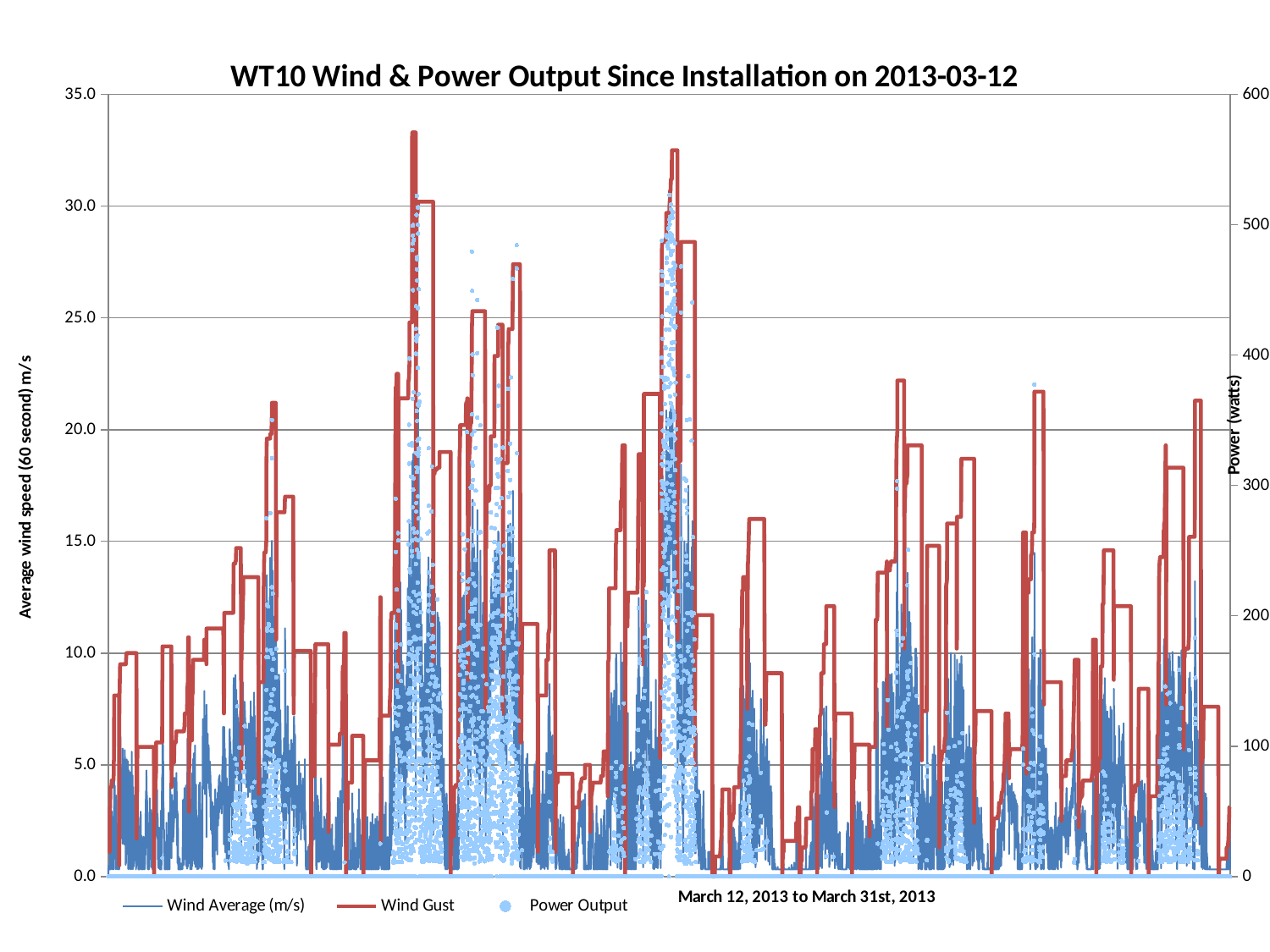
What is the title of the chart? WT10 Wind & Power Output Since Installation on 2013-03-12 What is the title of the right-hand vertical axis? Power (watts) Is the highest Power Output value on the chart greater or less than 400 watts? greater How many series does the chart's legend list? 3 What kind of chart is shown on the slide? line chart Is the highest Wind Gust value on the chart greater or less than 35.0? less Is the highest Wind Gust value on the chart greater or less than 30.0? greater